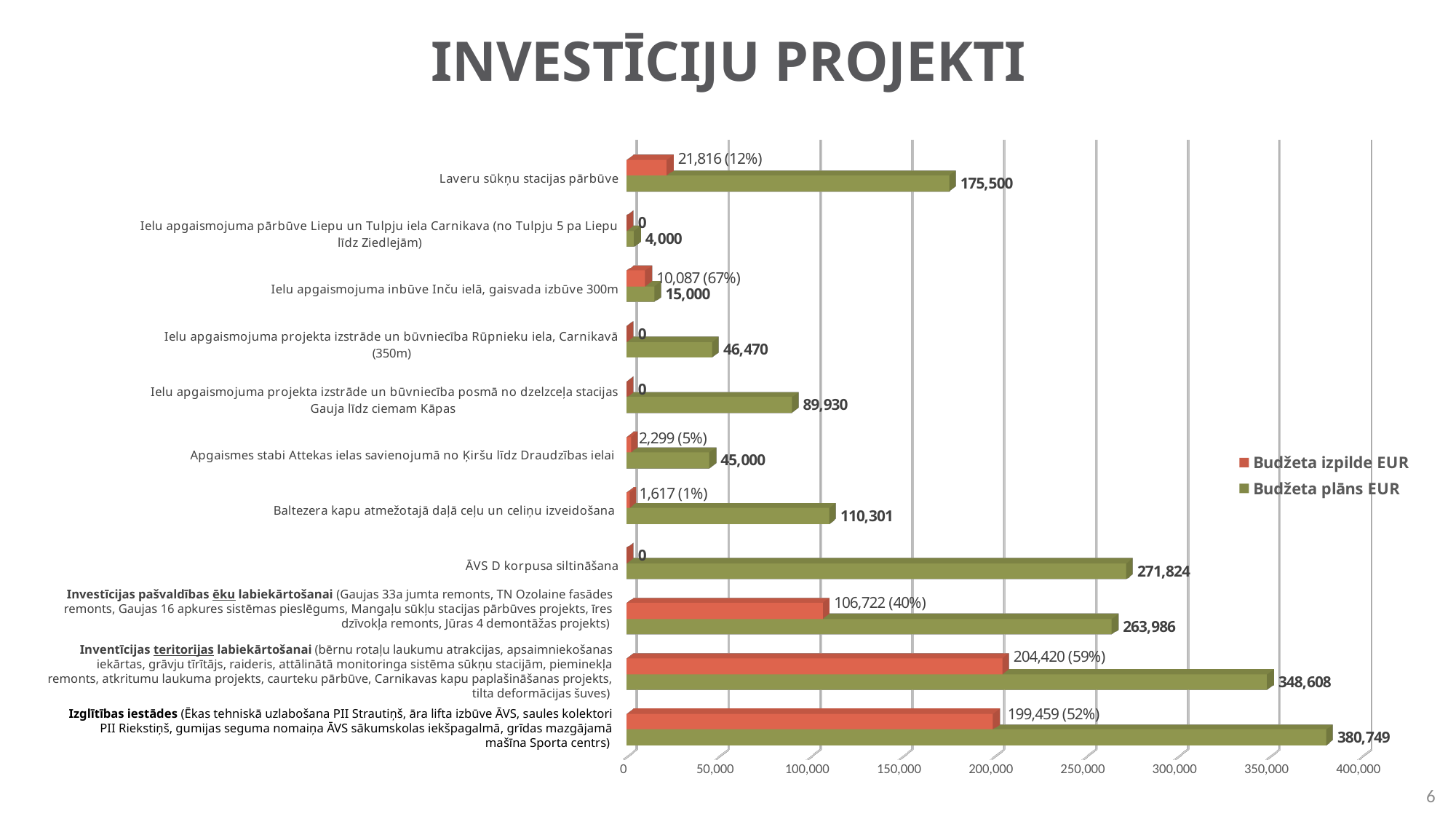
What is the Budžeta plāns EUR value for ĀVS D korpusa siltināšana? 271,824 How many categories are shown on the chart? 11 Which category has the highest Budžeta plāns EUR value? Izglītības iestādes What is the Budžeta plāns EUR value for Laveru sūkņu stacijas pārbūve? 175,500 What is the difference between the Budžeta plāns EUR and Budžeta izpilde EUR values for Izglītības iestādes? 181,290 Which is larger: the Budžeta plāns EUR value for Baltezera kapu atmežotajā daļā ceļu un celiņu izveidošana or for Ielu apgaismojuma projekta izstrāde un būvniecība posmā no dzelzceļa stacijas Gauja līdz ciemam Kāpas? Baltezera kapu atmežotajā daļā ceļu un celiņu izveidošana How many series does the legend list? 2 Which category has the lowest Budžeta plāns EUR value? Ielu apgaismojuma pārbūve Liepu un Tulpju iela Carnikava (no Tulpju 5 pa Liepu līdz Ziedlejām) Which category has the highest Budžeta izpilde EUR value? Inventīcijas teritorijas labiekārtošanai What is the difference between the Budžeta plāns EUR and Budžeta izpilde EUR values for Laveru sūkņu stacijas pārbūve? 153,684 What kind of chart is shown on the slide? Bar chart What is the Budžeta izpilde EUR value for Ielu apgaismojuma inbūve Inču ielā, gaisvada izbūve 300m? 10,087 (67%)